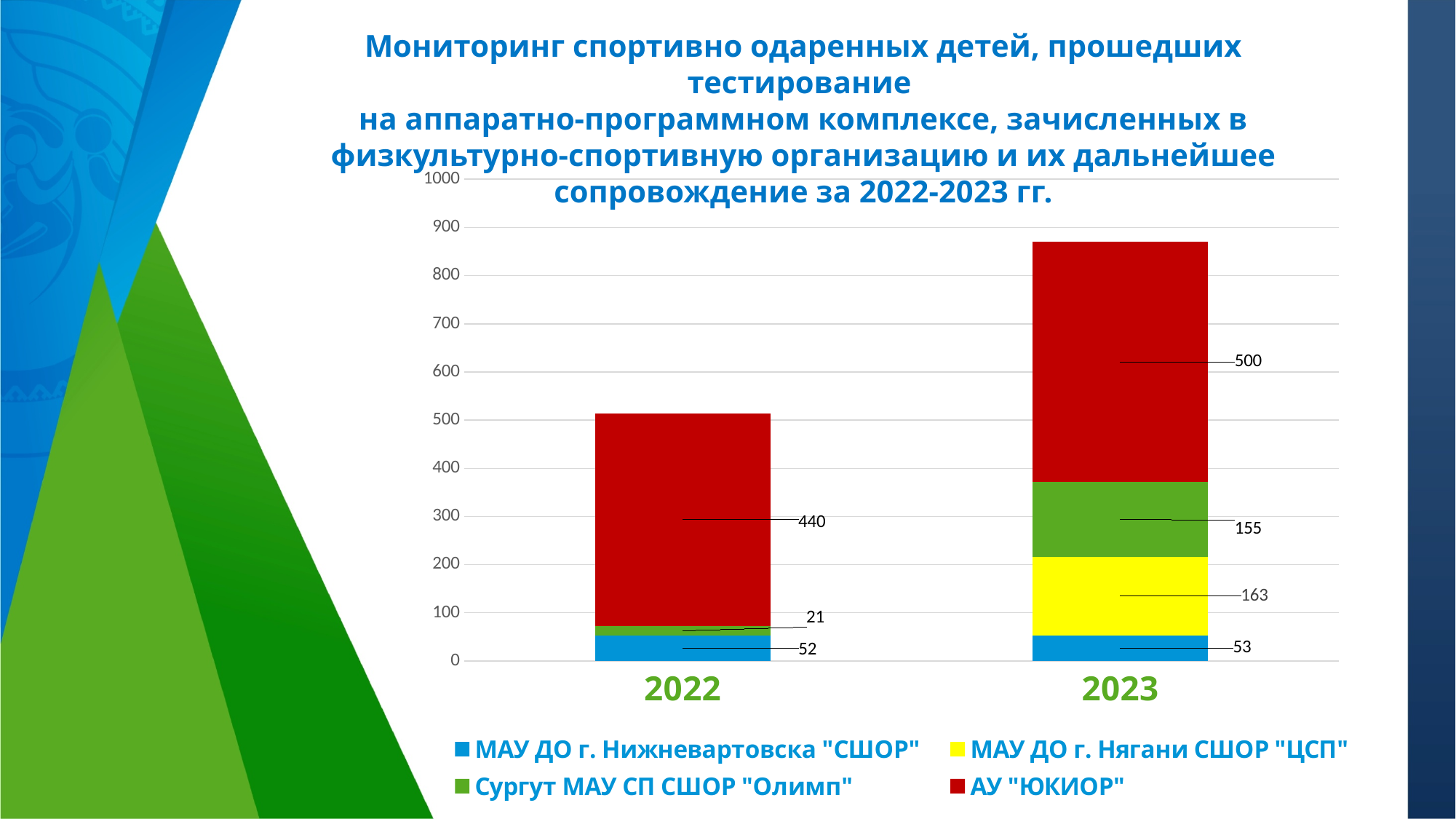
What kind of chart is shown on the slide? Stacked bar chart In 2023, which is larger: МАУ ДО г. Нягани СШОР "ЦСП" or Сургут МАУ СП СШОР "Олимп"? МАУ ДО г. Нягани СШОР "ЦСП" What is the value for Сургут МАУ СП СШОР "Олимп" in 2023? 155 How many series does the legend list? 4 What is the value for МАУ ДО г. Нягани СШОР "ЦСП" in 2023? 163 What is the value for Сургут МАУ СП СШОР "Олимп" in 2022? 21 What is the value for МАУ ДО г. Нижневартовска "СШОР" in 2022? 52 What is the total of the stacked bar for 2023? 871 By how much did the value for АУ "ЮКИОР" increase from 2022 to 2023? 60 What is the value for АУ "ЮКИОР" in 2023? 500 What is the value for АУ "ЮКИОР" in 2022? 440 Is the total height of the 2022 bar greater or less than 500? greater